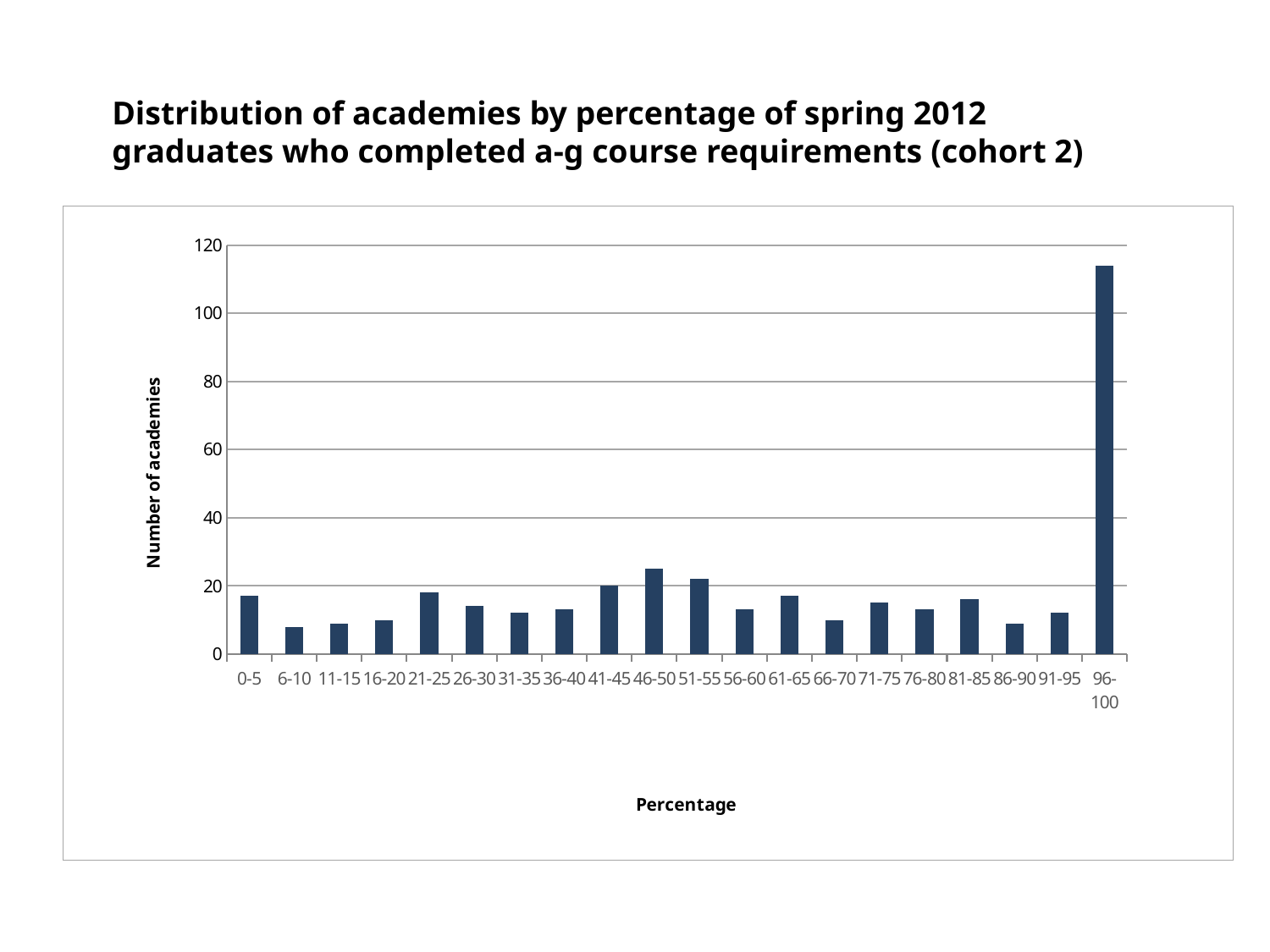
Is the number of academies for the 46-50 category greater or less than 20? greater Which percentage category has the highest number of academies? 96-100 How many percentage categories are shown on the x axis? 20 Which has more academies, the 46-50 category or the 0-5 category? 46-50 Which has more academies, the 96-100 category or the 46-50 category? 96-100 What kind of chart is shown on the slide? bar chart What is the label of the vertical axis? Number of academies What is the label of the horizontal axis? Percentage Is the number of academies for the 96-100 category greater or less than 100? greater Is the number of academies for the 6-10 category greater or less than 20? less